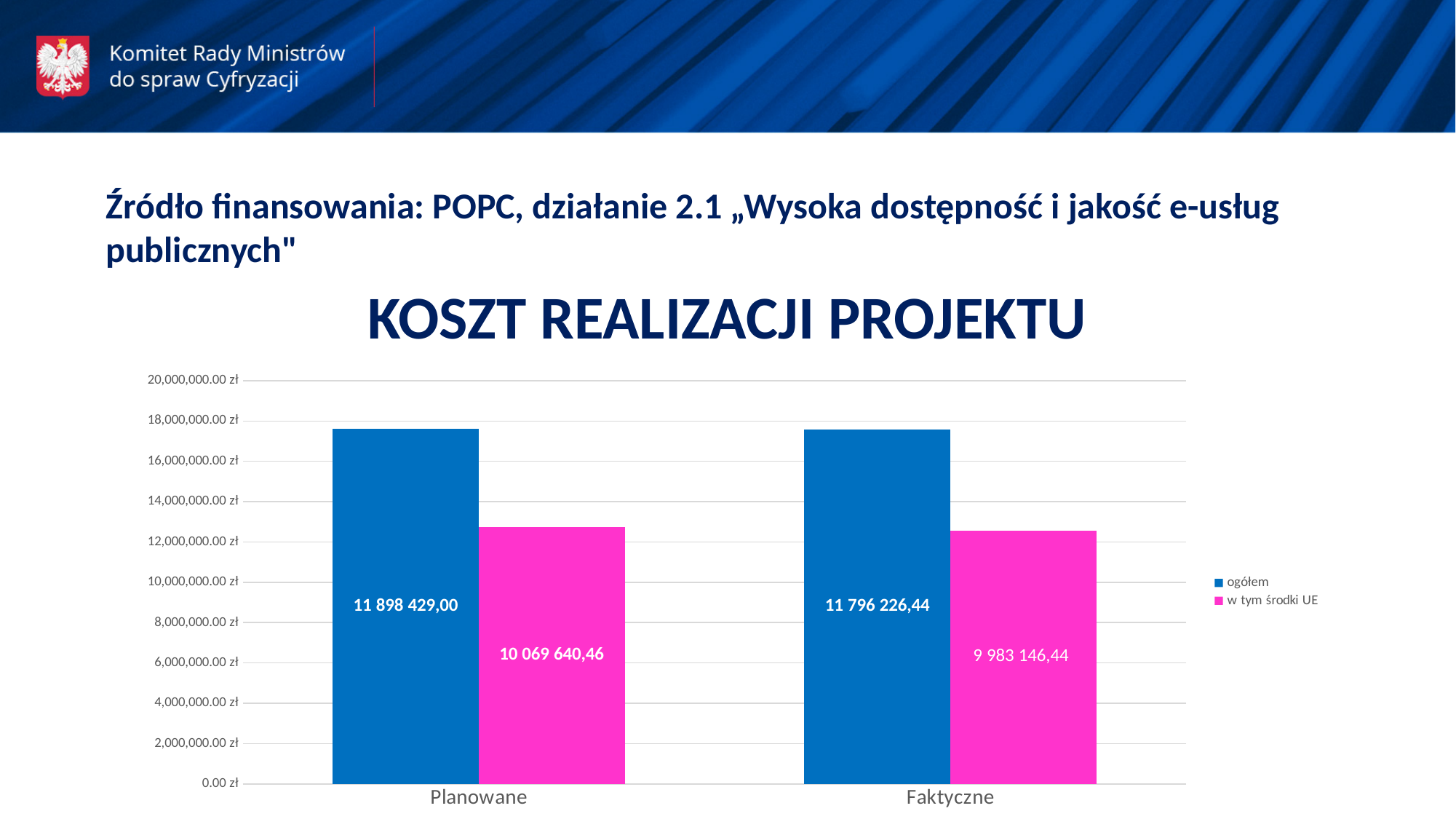
What type of chart is shown on the slide? Bar chart Which bar has the lowest labelled value on the chart? Faktyczne, w tym środki UE What is the difference between the 'ogółem' and 'w tym środki UE' values for Faktyczne? 1 813 080,00 How many series does the legend list? 2 What is the value of the 'ogółem' bar for Faktyczne? 11 796 226,44 What is the difference between the 'ogółem' values for Planowane and Faktyczne? 102 202,56 What is the value of the 'ogółem' bar for Planowane? 11 898 429,00 Which bar has the highest labelled value on the chart? Planowane, ogółem How many categories are shown on the x axis? 2 What is the value of the 'w tym środki UE' bar for Faktyczne? 9 983 146,44 What is the value of the 'w tym środki UE' bar for Planowane? 10 069 640,46 Which is larger: the 'w tym środki UE' value for Planowane or for Faktyczne? Planowane